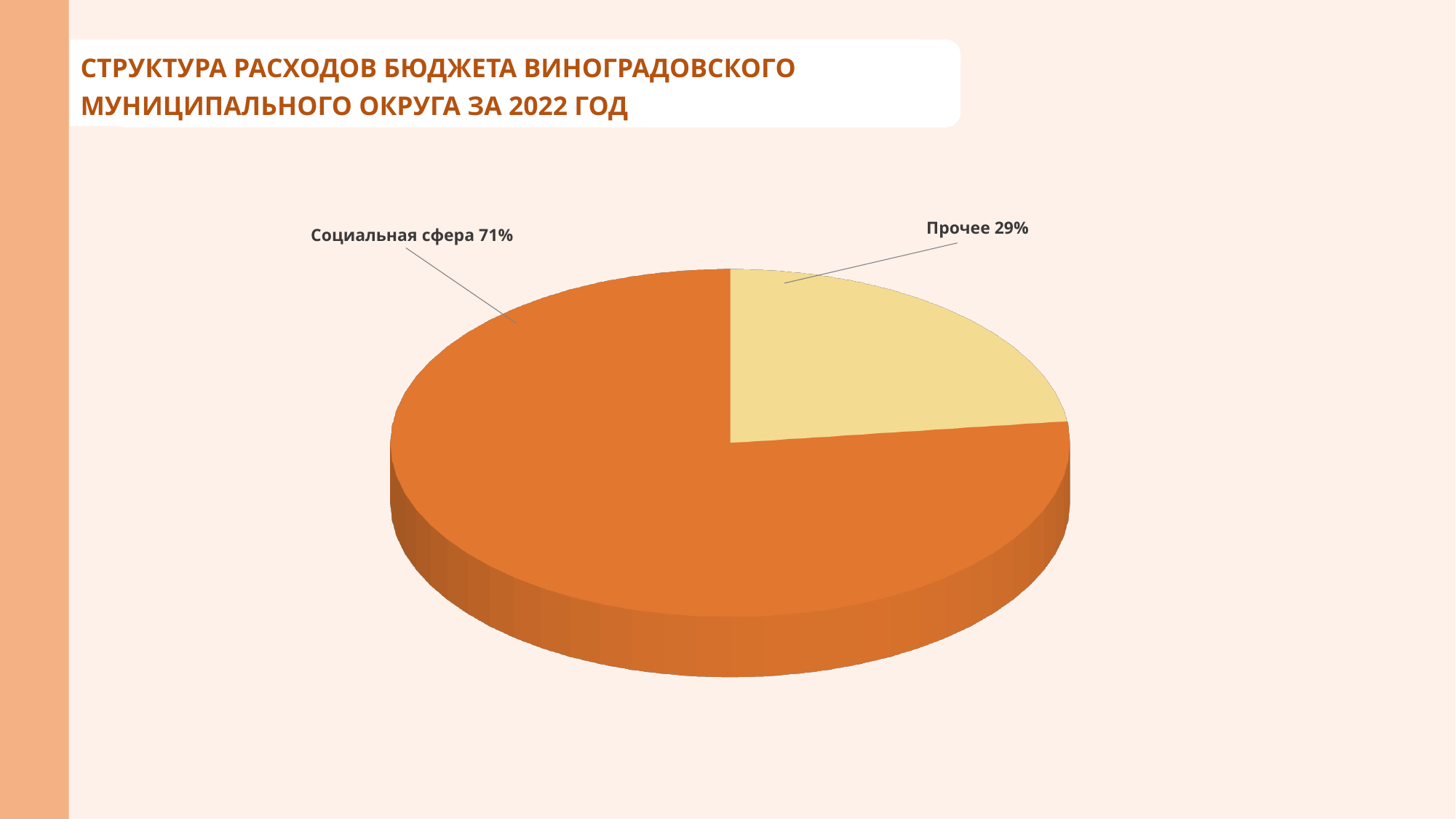
What is the difference in percentage points between Социальная сфера and Прочее? 42 Which category has the largest slice of the pie? Социальная сфера What share of the pie does Социальная сфера take? 71% Which is larger, the slice for Социальная сфера or the slice for Прочее? Социальная сфера Which category has the smallest slice of the pie? Прочее What kind of chart is shown on the slide? Pie chart What colour is the slice for Прочее? Light yellow What is the total of the two slice percentages shown? 100% How many slices does the pie chart have? 2 What is the title of the slide? СТРУКТУРА РАСХОДОВ БЮДЖЕТА ВИНОГРАДОВСКОГО МУНИЦИПАЛЬНОГО ОКРУГА ЗА 2022 ГОД What share of the pie does Прочее take? 29%